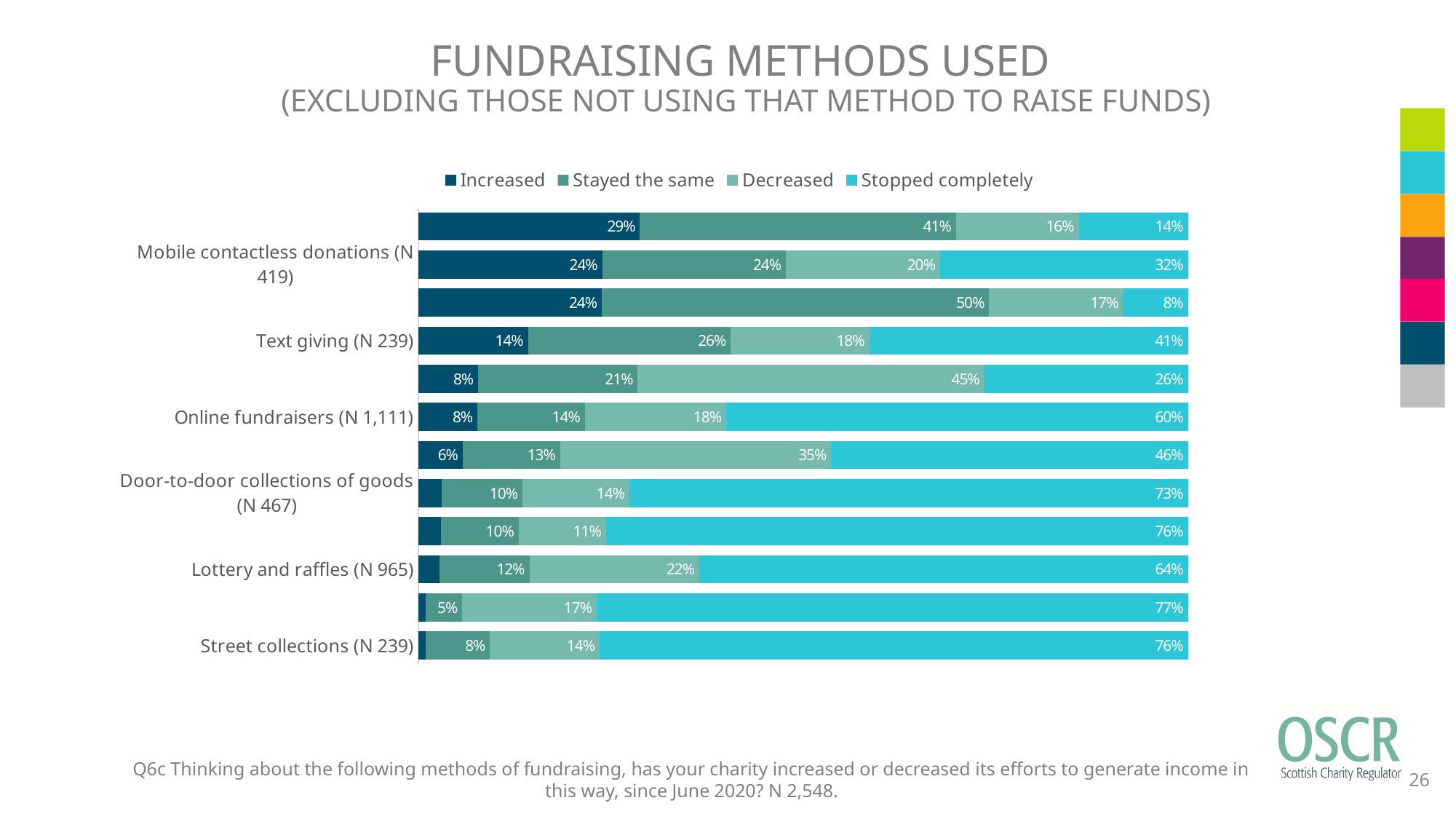
What kind of chart is shown on the slide? bar chart How many bars are plotted in the chart? 12 What is the 'Increased' value shown on the topmost bar of the chart? 29% Which series has the largest share of the bar for Online fundraisers (N 1,111)? Stopped completely What is the 'Increased' value for Mobile contactless donations (N 419)? 24% What is the difference between the 'Stopped completely' and 'Increased' values for Online fundraisers (N 1,111)? 52 percentage points Which has the larger 'Stopped completely' value: Text giving (N 239) or Online fundraisers (N 1,111)? Online fundraisers (N 1,111) What is the 'Stopped completely' value for Online fundraisers (N 1,111)? 60% What is the 'Stayed the same' value for Lottery and raffles (N 965)? 12% What are the four legend entries in the chart? Increased, Stayed the same, Decreased, Stopped completely What is the 'Stopped completely' value for Text giving (N 239)? 41% How many series does the legend list? 4